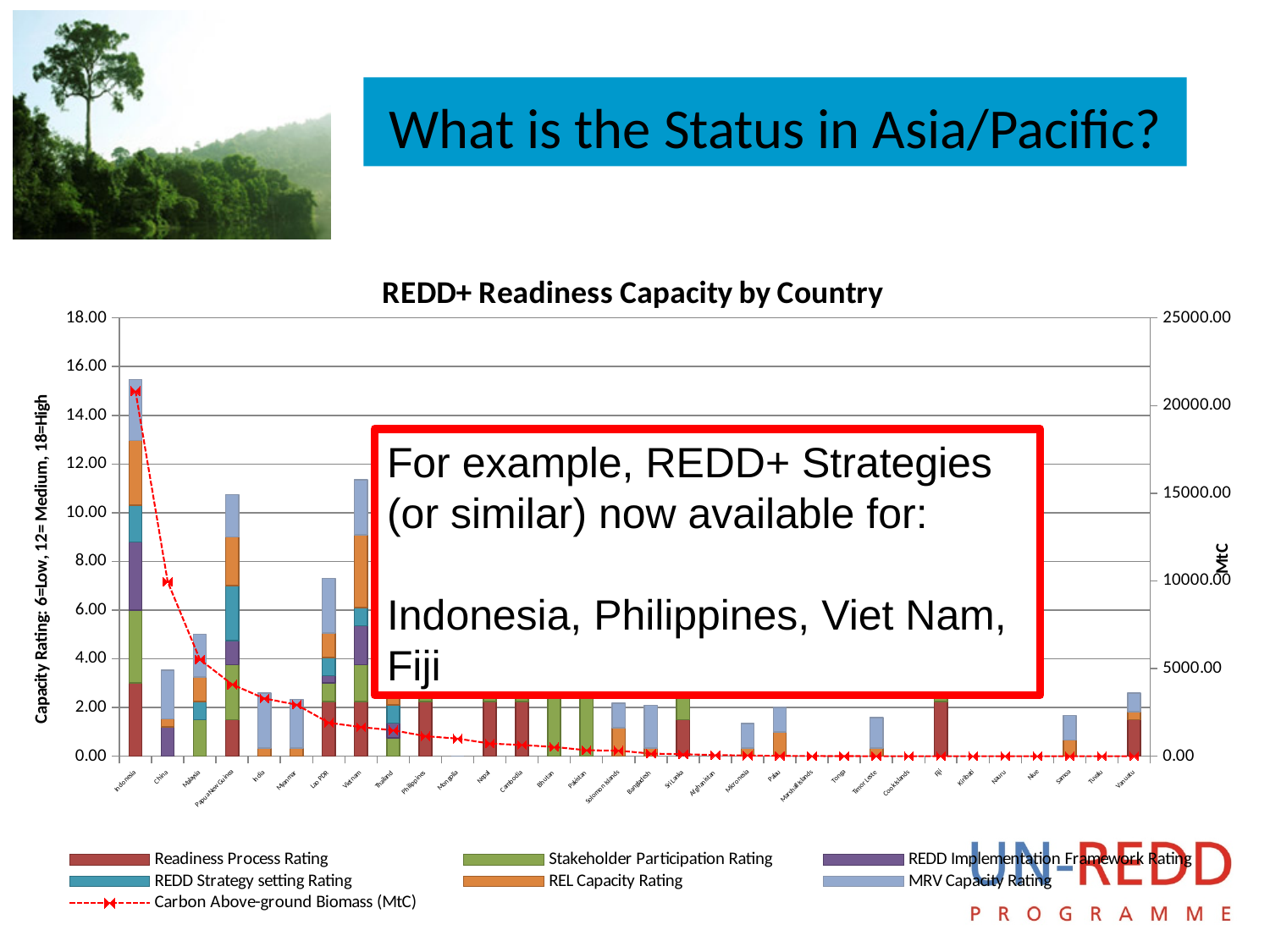
Is the total capacity rating bar for Indonesia greater or less than 14.00? greater How many countries are shown on the x axis of the REDD+ Readiness Capacity chart? 32 Is the total capacity rating bar for Lao PDR greater or less than 6.00? greater Which has the larger total capacity rating bar, Papua New Guinea or Lao PDR? Papua New Guinea What kind of chart is used to show the REDD+ Readiness Capacity by Country? Stacked bar chart with a line series What is the title of the chart on the slide? REDD+ Readiness Capacity by Country Which country has the highest total capacity rating bar in the chart? Indonesia Is the total capacity rating bar for Papua New Guinea greater or less than 10.00? greater Which has the larger total capacity rating bar, Indonesia or Viet Nam? Indonesia Does the Carbon Above-ground Biomass (MtC) line rise or fall from left to right across the countries? fall How many series does the legend of the REDD+ Readiness Capacity chart list? 7